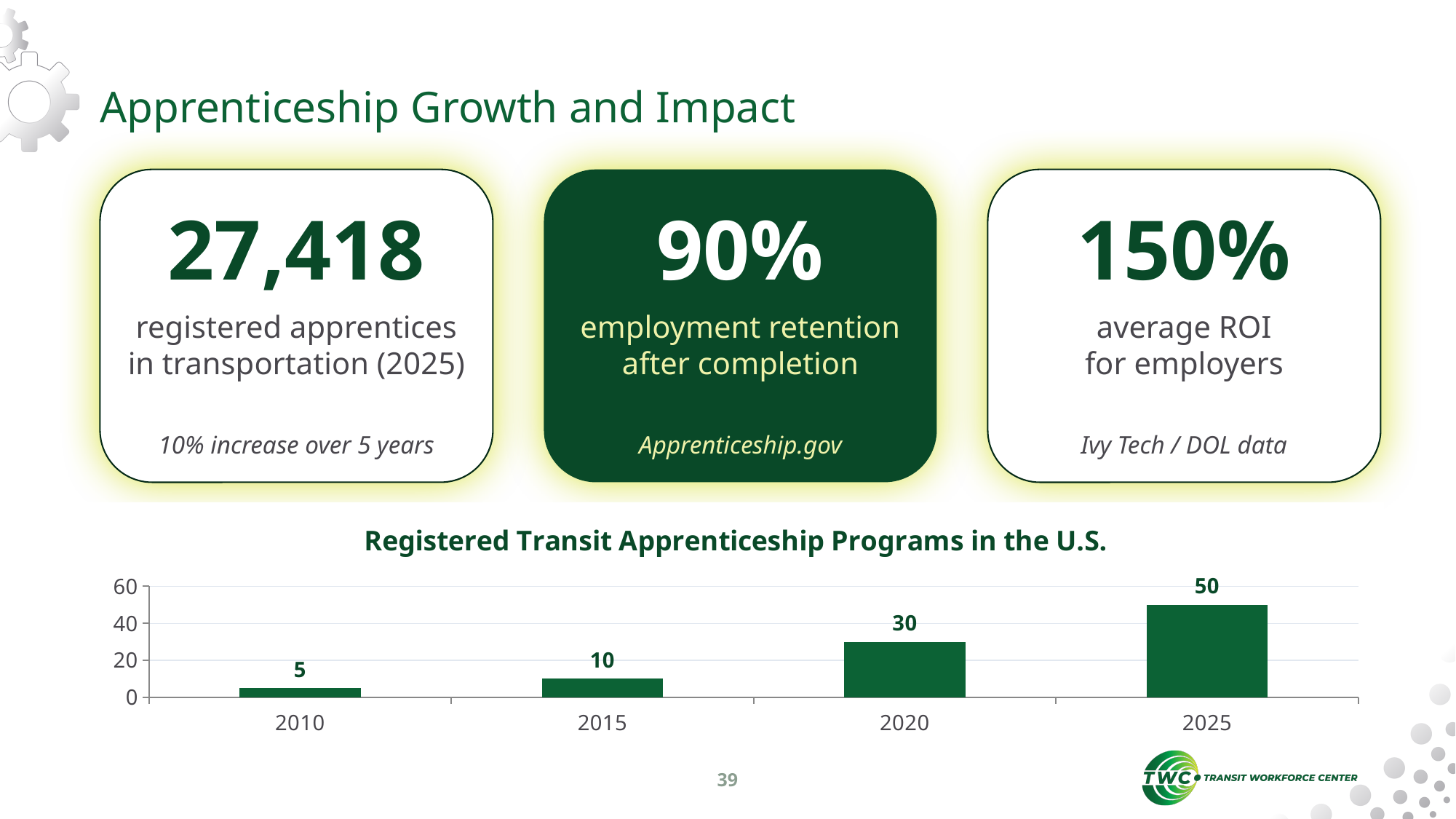
How many years are shown on the x axis of the chart? 4 What kind of chart is shown on the slide? bar chart Which year has the lowest value in the chart? 2010 What is the value for 2020 in the chart? 30 What is the value for 2010 in the chart? 5 Which is larger, the value for 2015 or the value for 2020? 2020 What is the value for 2025 in the chart? 50 What is the value for 2015 in the chart? 10 Do the values rise or fall from 2010 to 2025? rise What is the difference between the values for 2025 and 2020? 20 Is the value for 2025 greater or less than 40? greater Which year has the highest value in the chart? 2025